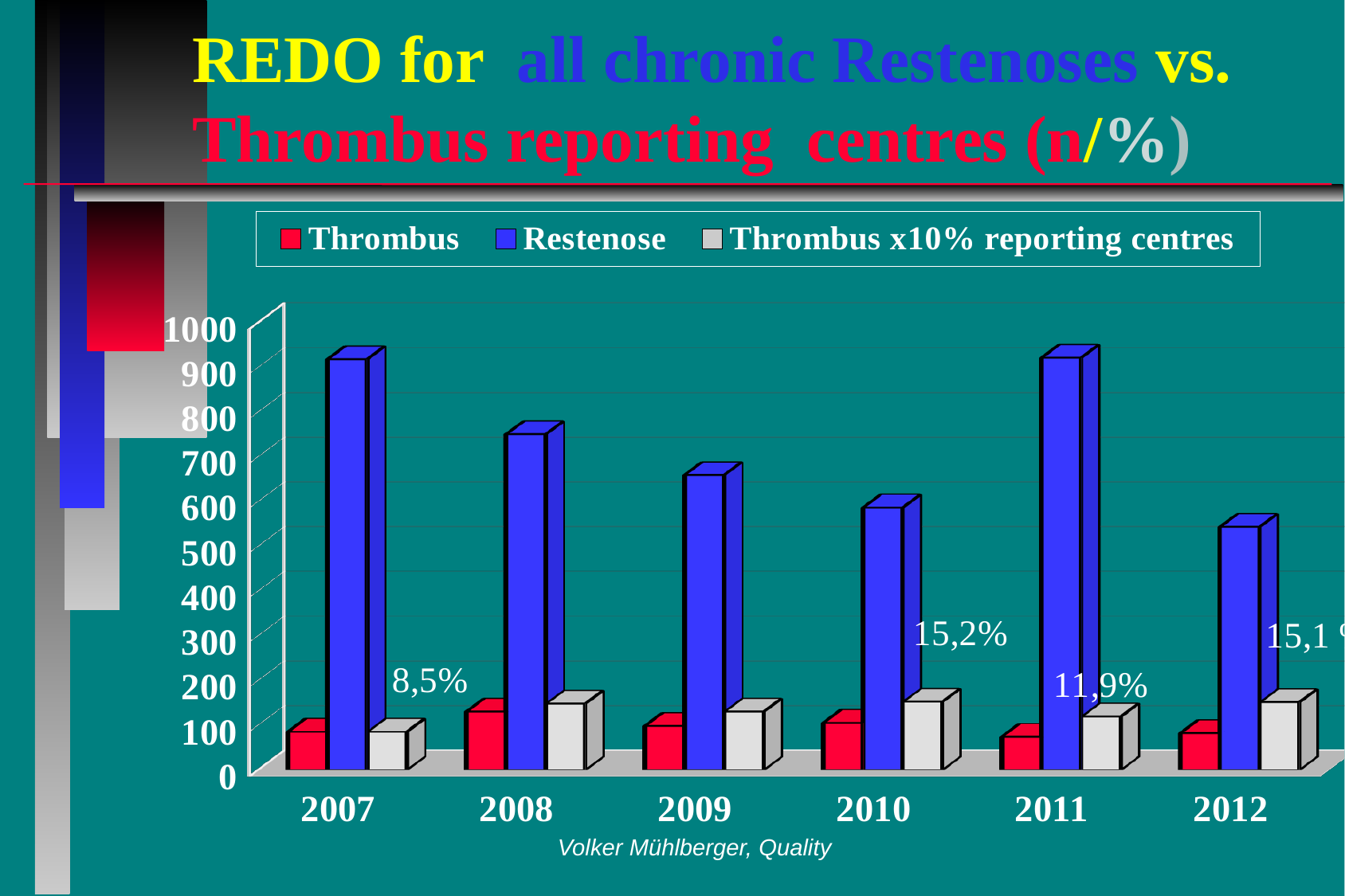
Is the Restenose value for 2009 greater or less than 600? greater How many years are shown on the x axis? 6 What kind of chart is shown on the slide? bar chart Which is larger, the Restenose value for 2008 or for 2009? 2008 Is the Restenose value for 2012 greater or less than 600? less What percentage label is printed next to the 2007 bars? 8,5% Is the Restenose value for 2007 greater or less than 800? greater Do the Restenose values rise or fall from 2007 to 2010? fall What percentage label is printed next to the 2011 bars? 11,9% How many series does the legend list? 3 Which year has the lowest Restenose value? 2012